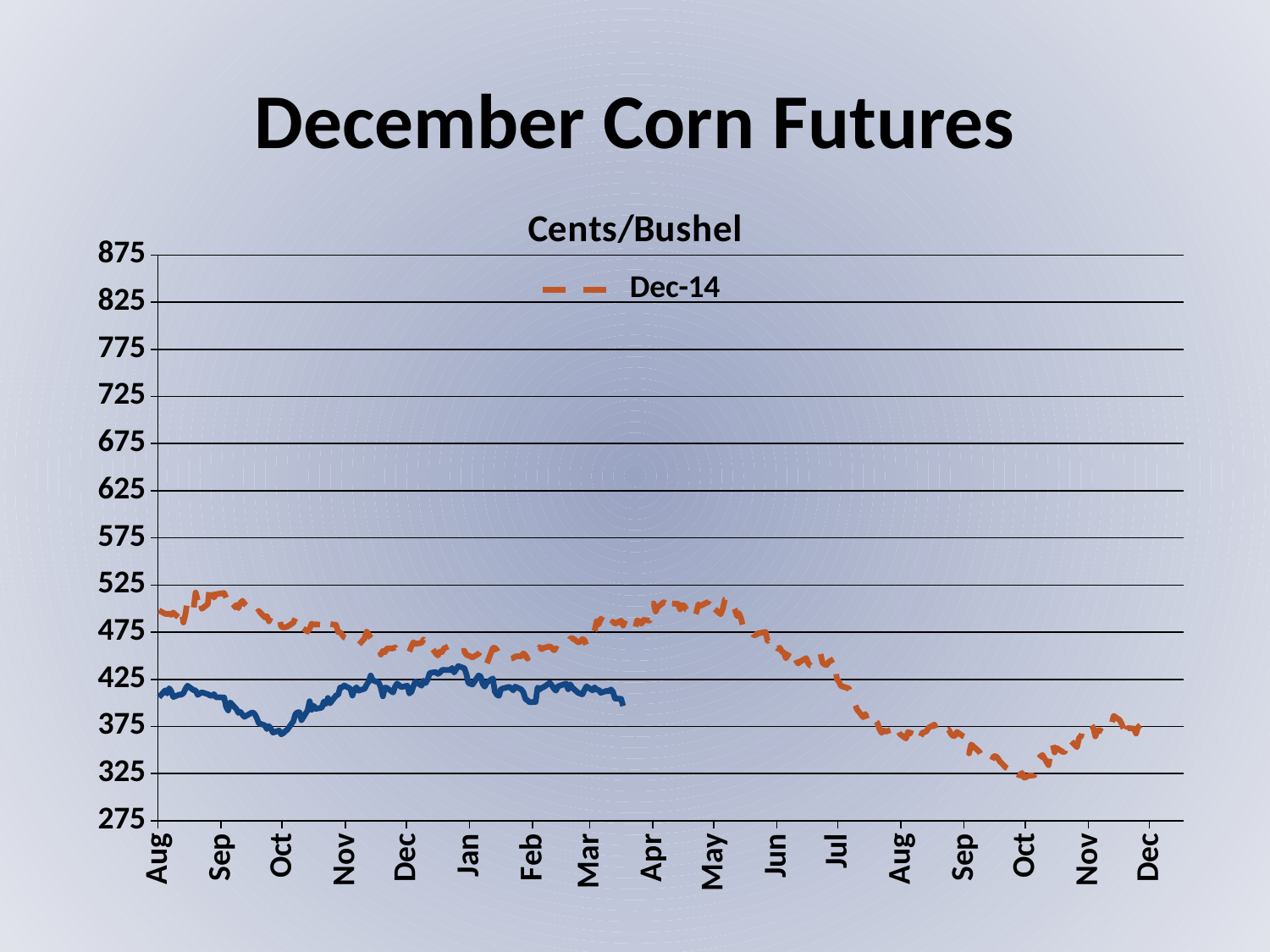
Is the value of the Dec-14 series at the second Oct label greater or less than 375? less Does the Dec-14 series rise or fall between the Jul label and the second Oct label? fall What is the title printed above the chart's plot area? Cents/Bushel Is the value of the Dec-14 series at the first Aug label greater or less than 475? greater Is the value of the Dec-14 series at the final Dec label greater or less than 425? less Is the Dec-14 series higher at the first Aug label or at the second Oct label? first Aug What is the name of the series shown in the legend? Dec-14 How many month labels are shown along the x axis? 17 Around which month label does the Dec-14 series reach its lowest point? Oct (the second Oct) What kind of chart is shown on the slide? line chart How many series does the legend list? 1